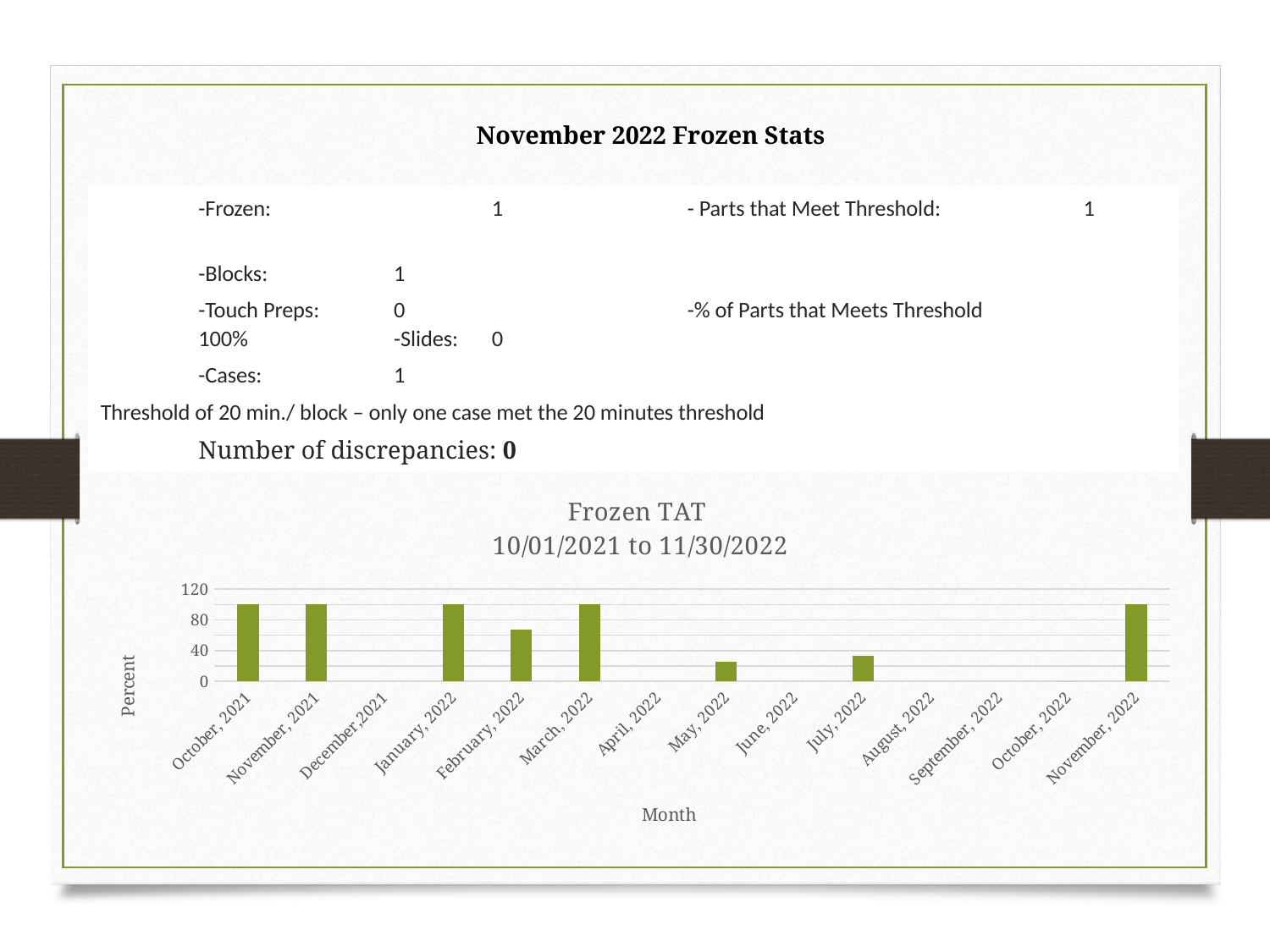
Is the value for February, 2022 greater or less than 80? less Is the value for May, 2022 greater or less than 40? less Which is larger, the value for January, 2022 or the value for July, 2022? January, 2022 What kind of chart is shown on the slide? bar chart Is the value for October, 2021 greater or less than 80? greater What is the title of the chart? Frozen TAT 10/01/2021 to 11/30/2022 What is the label of the y axis of the chart? Percent Which is larger, the value for February, 2022 or the value for May, 2022? February, 2022 How many months are shown on the x axis of the Frozen TAT chart? 14